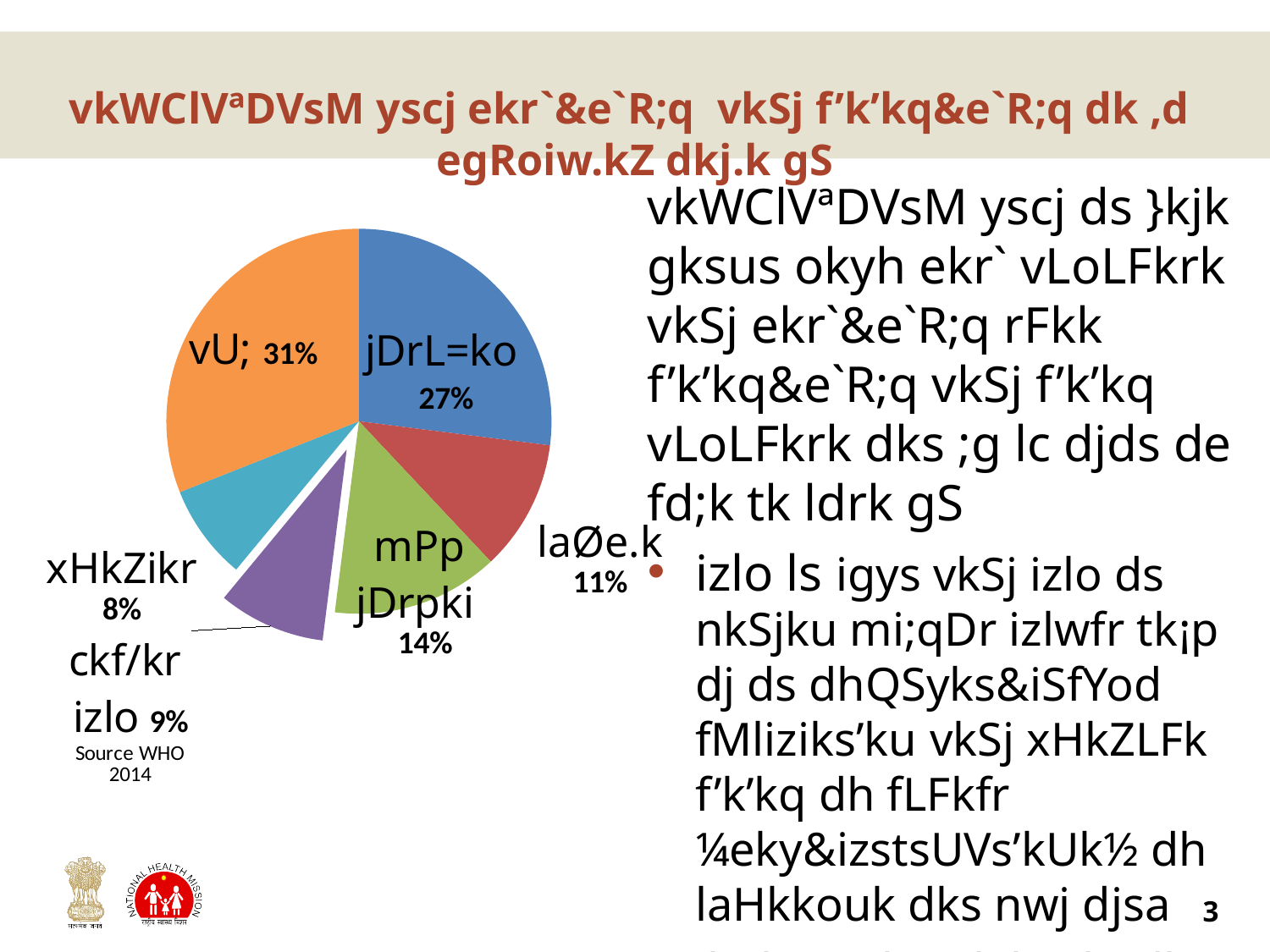
What percentage is shown for the slice labelled "mPp jDrpki"? 14% What source is cited below the pie chart? Source WHO 2014 Which slice of the pie chart has the smallest share? xHkZikr How many slices does the pie chart have? 6 What percentage is shown for the slice labelled "jDrL=ko"? 27% What percentage is shown for the slice labelled "xHkZikr"? 8% What percentage is shown for the slice labelled "laØe.k"? 11% Which slice is larger, "mPp jDrpki" or "laØe.k"? mPp jDrpki Which slice of the pie chart has the largest share? vU; What type of chart is shown on the slide? pie chart What percentage is shown for the slice labelled "vU;"? 31% What is the difference in percentage points between the "vU;" slice and the "jDrL=ko" slice? 4